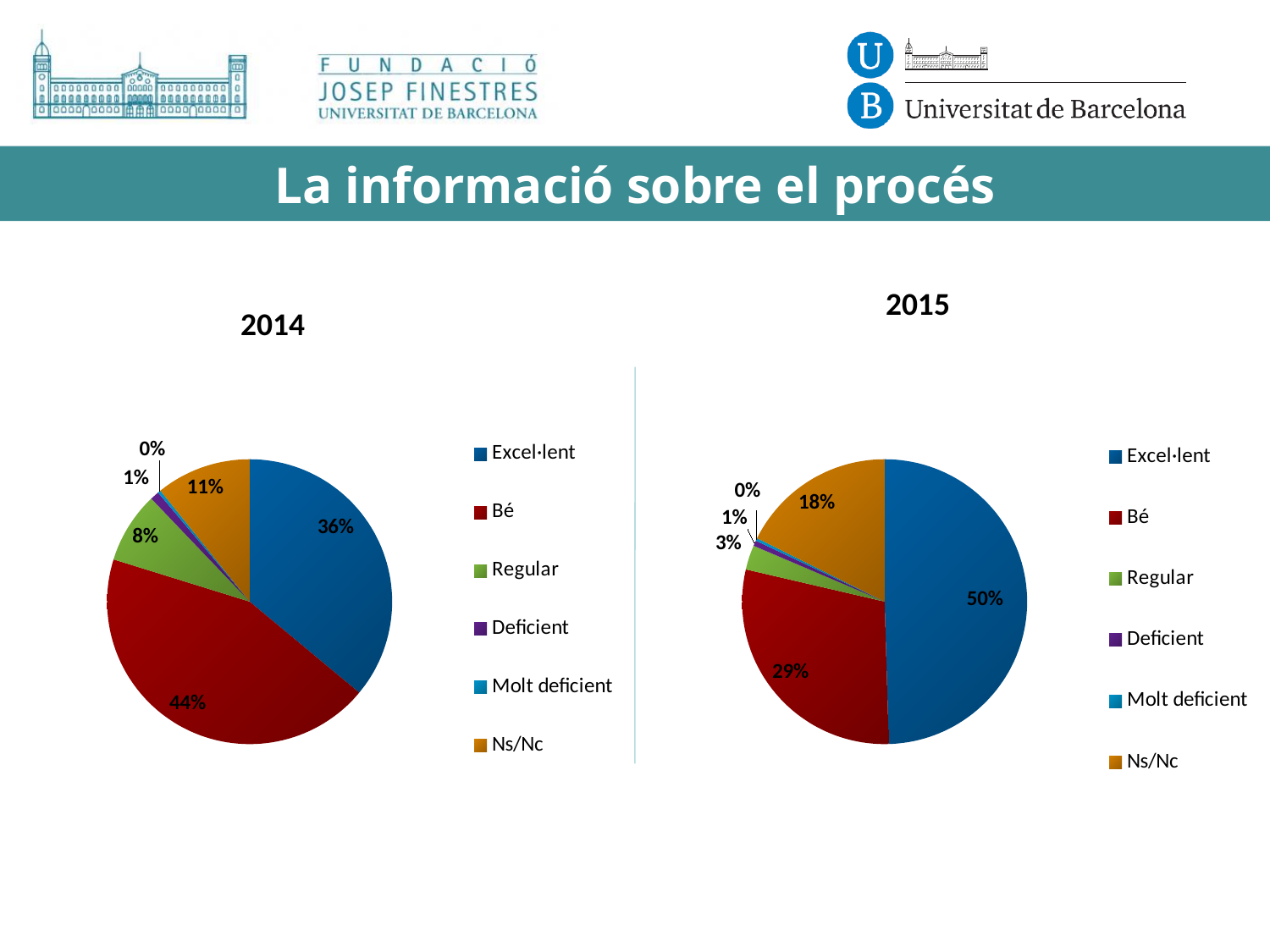
In the 2015 chart, what percentage is shown for Excel·lent? 50% What is the title of the chart on the right side of the slide? 2015 In the 2014 chart, what percentage is shown for Bé? 44% In the 2015 chart, which is larger, Ns/Nc or Bé? Bé How many categories does the legend of the 2015 chart list? 6 In the 2015 chart, which category has the largest slice? Excel·lent In the 2014 chart, which category has the largest slice? Bé In the 2014 chart, what is the difference between the Bé and Excel·lent percentages? 8% What type of chart is used for the 2014 data? Pie chart In the 2015 chart, what percentage is shown for Regular? 3% In the 2015 chart, which category has the smallest slice? Molt deficient In the 2014 chart, what percentage is shown for Ns/Nc? 11%